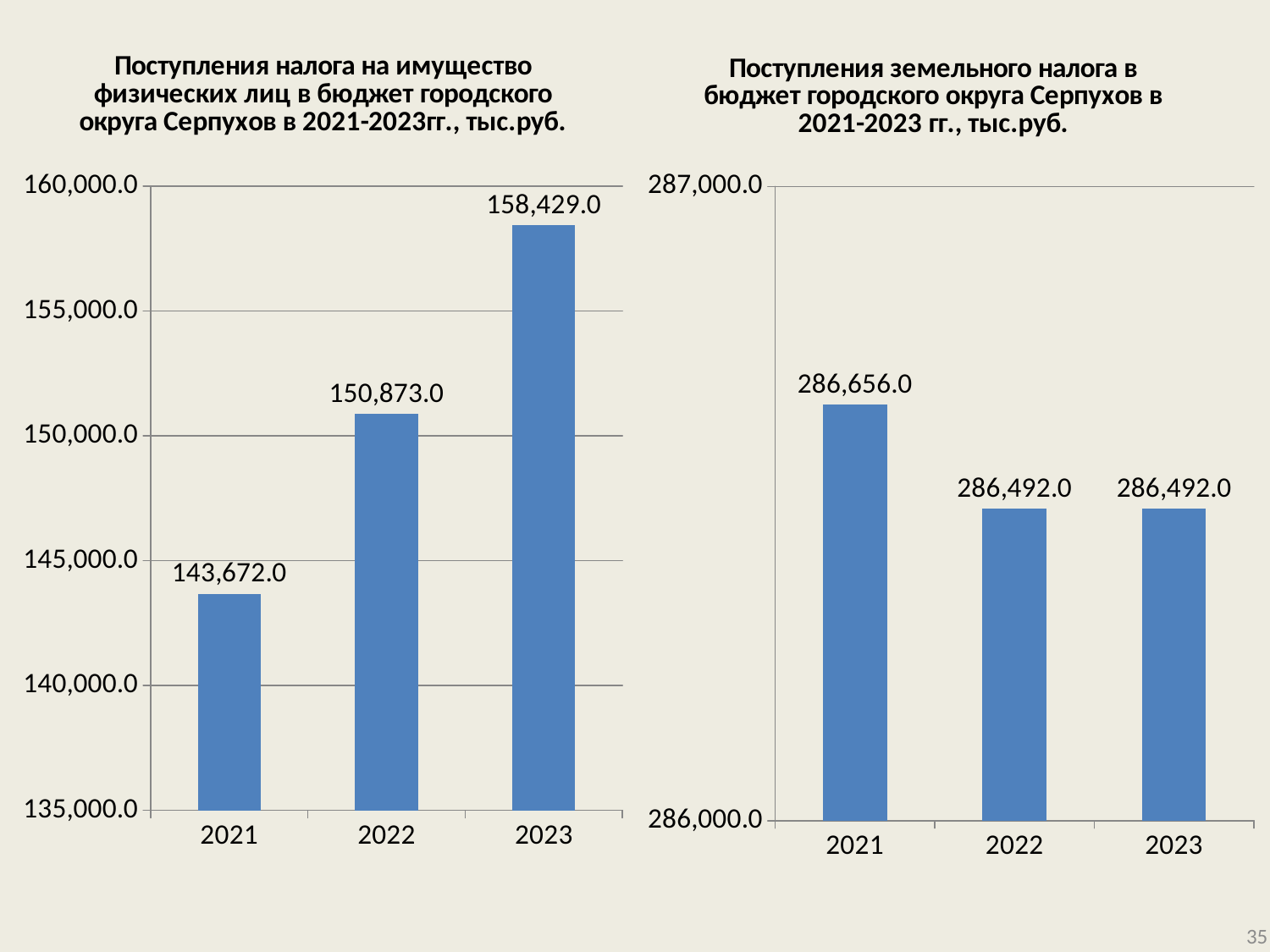
How many bars does the right chart (land tax receipts) show? 3 In the left chart (property tax receipts), what is the value for 2021? 143,672.0 In the left chart (property tax receipts), is the value for 2022 greater or less than 150,000.0? greater In the left chart (property tax receipts), what is the difference between the 2023 and 2021 values? 14,757.0 In the right chart (land tax receipts), what is the difference between the 2021 and 2022 values? 164.0 In the left chart (property tax receipts), what is the value for 2023? 158,429.0 In the right chart (land tax receipts), what is the value for 2022? 286,492.0 In the right chart (land tax receipts), what is the value for 2021? 286,656.0 In the left chart (property tax receipts), which year has the highest value? 2023 In the right chart (land tax receipts), which year has the highest value? 2021 In the left chart (property tax receipts), do the values rise or fall from 2021 to 2023? rise In the left chart (property tax receipts), which year has the lowest value? 2021